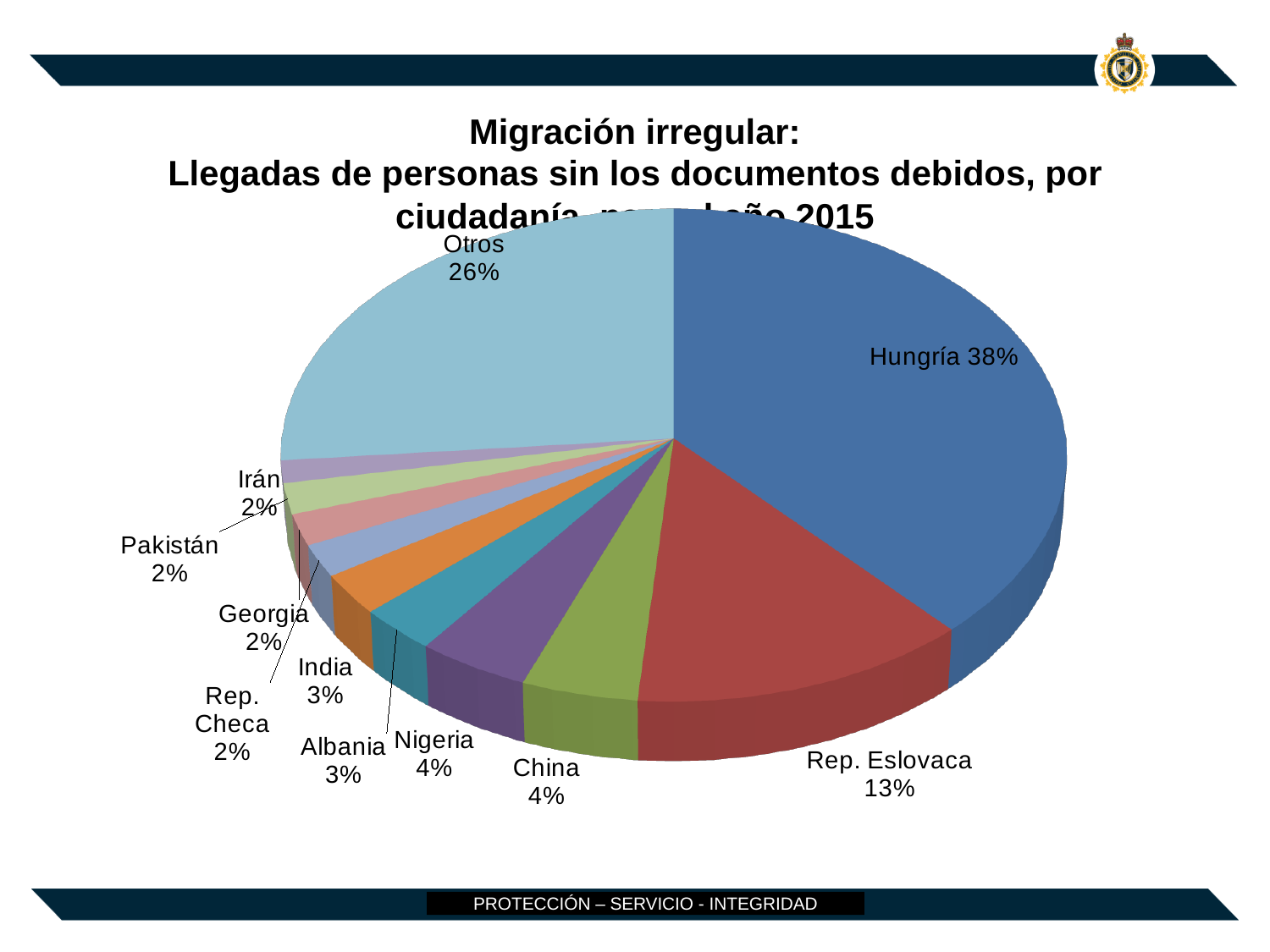
What percentage is shown for Otros? 26% What percentage is shown for Albania? 3% What is the difference in percentage points between China and India? 1 Which year does the chart title say the data refers to? 2015 What share of the pie does Hungría account for? 38% What percentage is shown for Nigeria? 4% How many slices does the pie chart have? 11 What kind of chart is shown on the slide? pie chart Which named country has the largest slice of the pie? Hungría What is the difference in percentage points between Hungría and Rep. Eslovaca? 25 Which is larger, the slice for Rep. Eslovaca or the slice for Otros? Otros What percentage is shown for Rep. Eslovaca? 13%